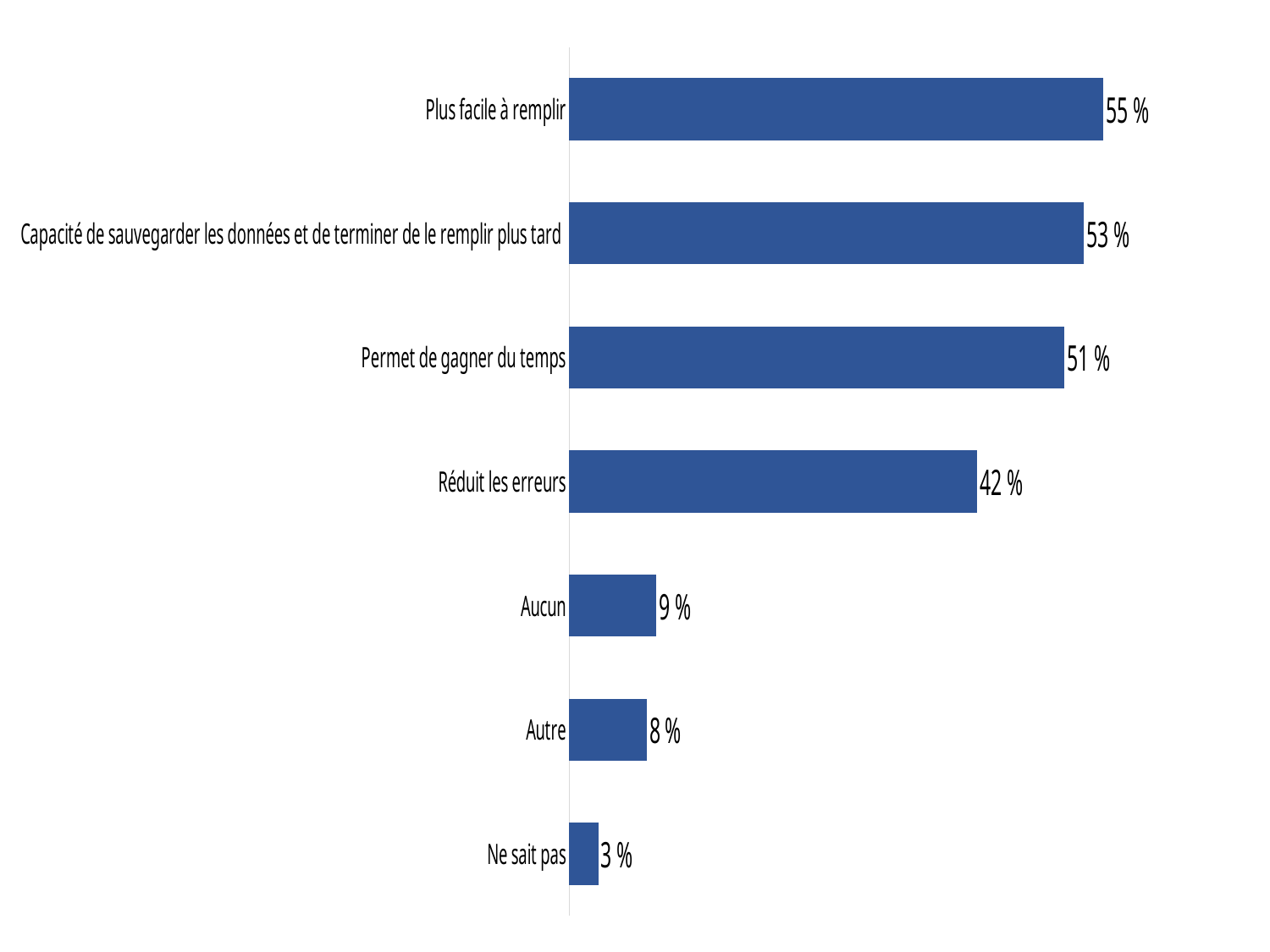
What is the value for "Capacité de sauvegarder les données et de terminer de le remplir plus tard"? 53 % What is the difference between the values for "Plus facile à remplir" and "Réduit les erreurs"? 13 % What is the difference between the values for "Aucun" and "Autre"? 1 % Which category has the highest value? Plus facile à remplir Which category has the lowest value? Ne sait pas What is the value for "Ne sait pas"? 3 % Which is larger, the value for "Permet de gagner du temps" or the value for "Réduit les erreurs"? Permet de gagner du temps What is the value for "Plus facile à remplir"? 55 % How many categories are shown in the chart? 7 What colour are the bars in the chart? Blue What kind of chart is shown on the slide? Bar chart What is the value for "Réduit les erreurs"? 42 %